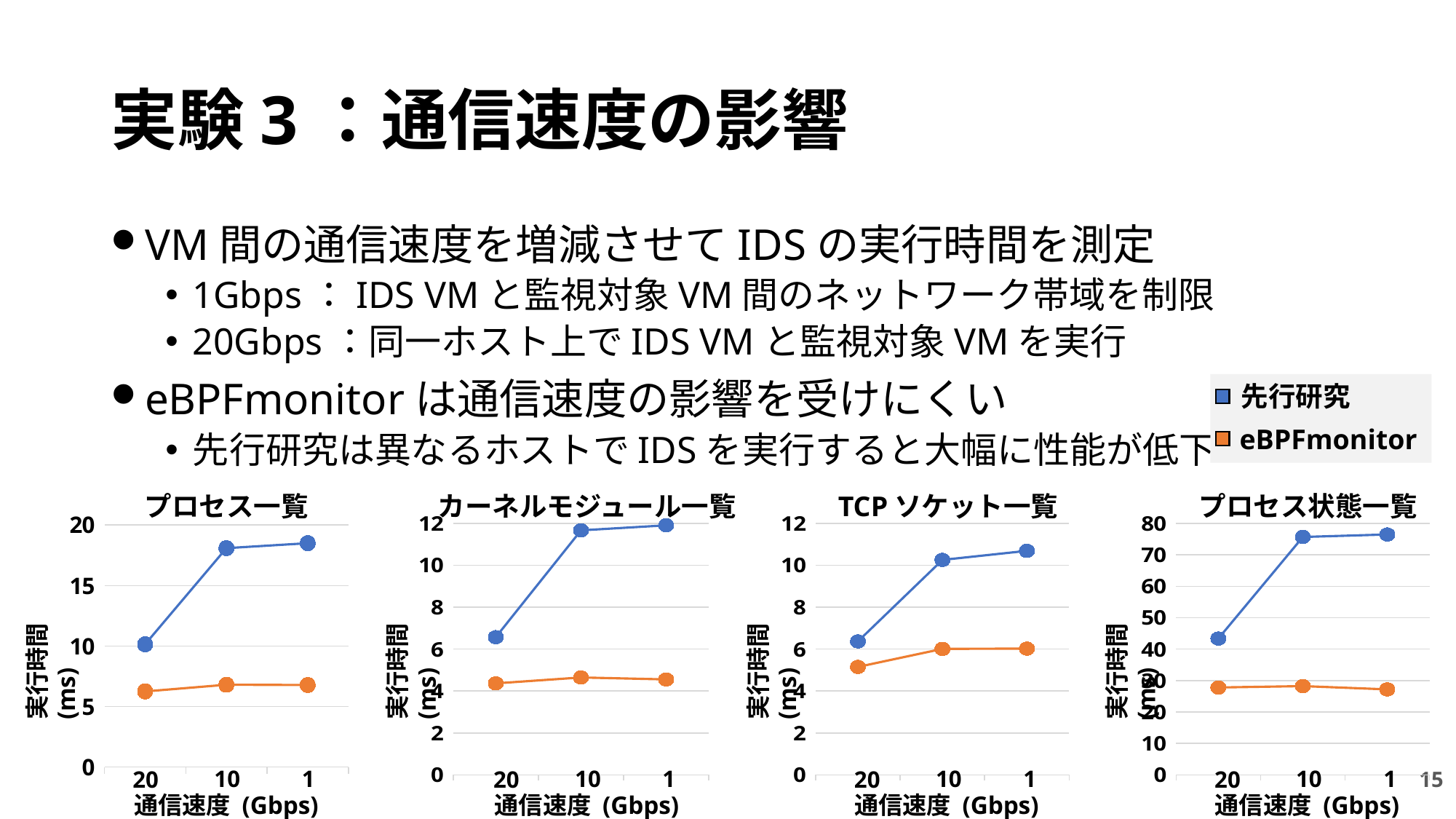
In the プロセス一覧 chart, is the 先行研究 value at 1 Gbps greater or less than 15? greater In the プロセス状態一覧 chart, does the 先行研究 series rise or fall from 20 Gbps to 1 Gbps along the x axis? rise How many series does the legend list for the charts? 2 In the TCP ソケット一覧 chart, is the 先行研究 value at 10 Gbps greater or less than 8? greater What is the x-axis label of the TCP ソケット一覧 chart? 通信速度 (Gbps) In the プロセス状態一覧 chart, is the 先行研究 value at 20 Gbps greater or less than 50? less In the プロセス一覧 chart, at which communication speed is the 先行研究 value lowest? 20 Gbps In the プロセス一覧 chart, which series has the higher value at 1 Gbps? 先行研究 What kind of chart is the プロセス一覧 chart? line chart In the プロセス一覧 chart, how many data points does the 先行研究 series have? 3